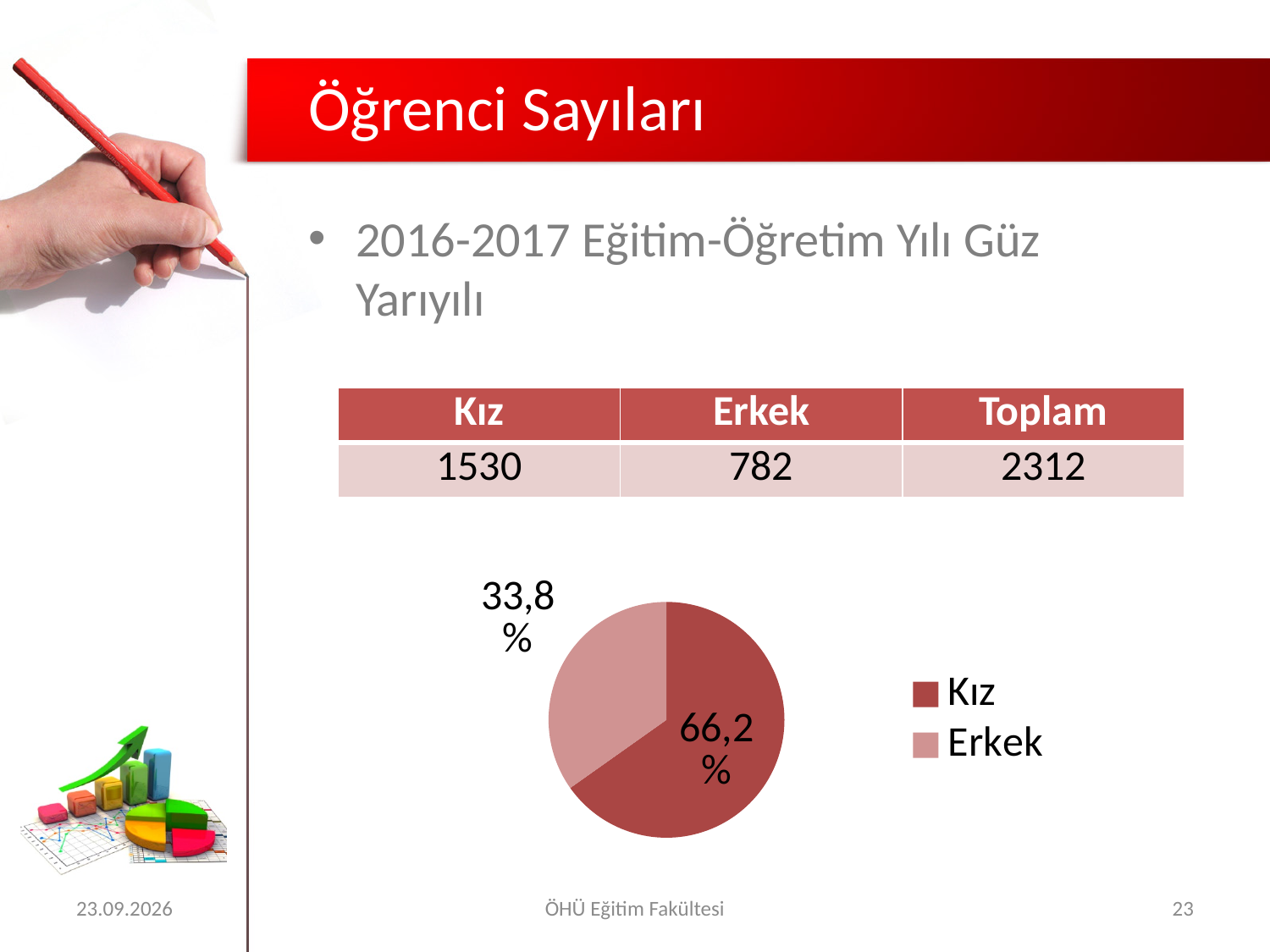
Which is larger in the pie chart, the Kız slice or the Erkek slice? Kız What is the difference in percentage points between the Kız slice and the Erkek slice in the pie chart? 32,4 What are the two legend entries of the pie chart? Kız and Erkek What share of the pie chart does the Kız slice represent? 66,2% Which slice of the pie chart is the smallest? Erkek How many slices does the pie chart have? 2 Which legend entry in the pie chart is shown in the darker red colour? Kız What share of the pie chart does the Erkek slice represent? 33,8% What type of chart is shown on the slide? pie chart Is the Kız slice of the pie chart greater or less than 50%? greater Which slice of the pie chart is the largest? Kız How many entries does the pie chart's legend list? 2